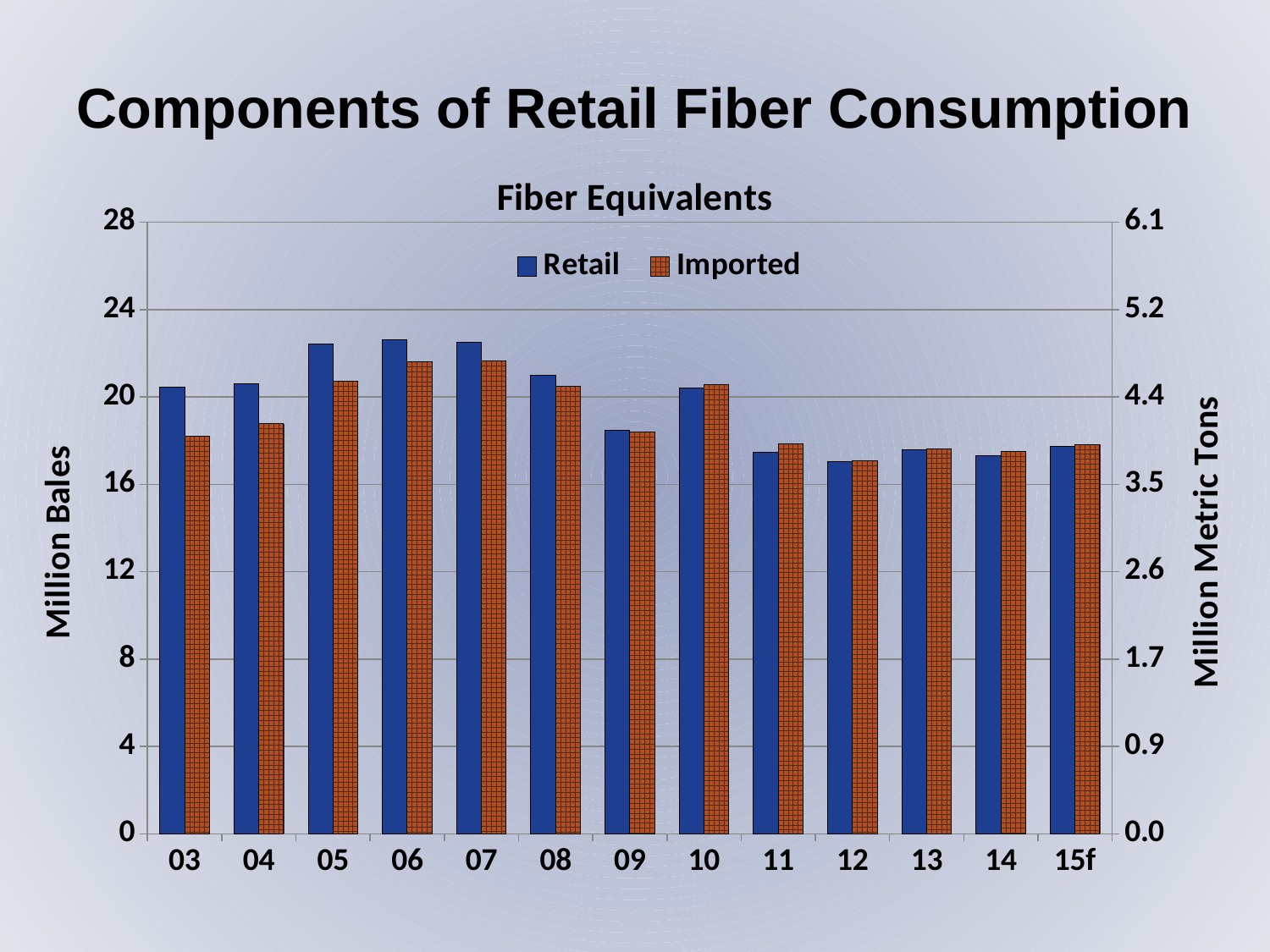
Do the Imported values rise or fall from 03 to 06? rise Is the Retail value for 12 greater or less than 16 million bales? greater How many series does the legend list? 2 What is the label on the left vertical axis? Million Bales In 03, which is larger, the Retail value or the Imported value? Retail Do the Retail values rise or fall from 07 to 12? fall Is the Retail value for 09 greater or less than 20 million bales? less Is the Retail value for 06 greater or less than 20 million bales? greater What kind of chart is shown on the slide? bar chart Which is larger, the Retail value for 06 or the Retail value for 09? 06 How many year categories are shown on the x axis? 13